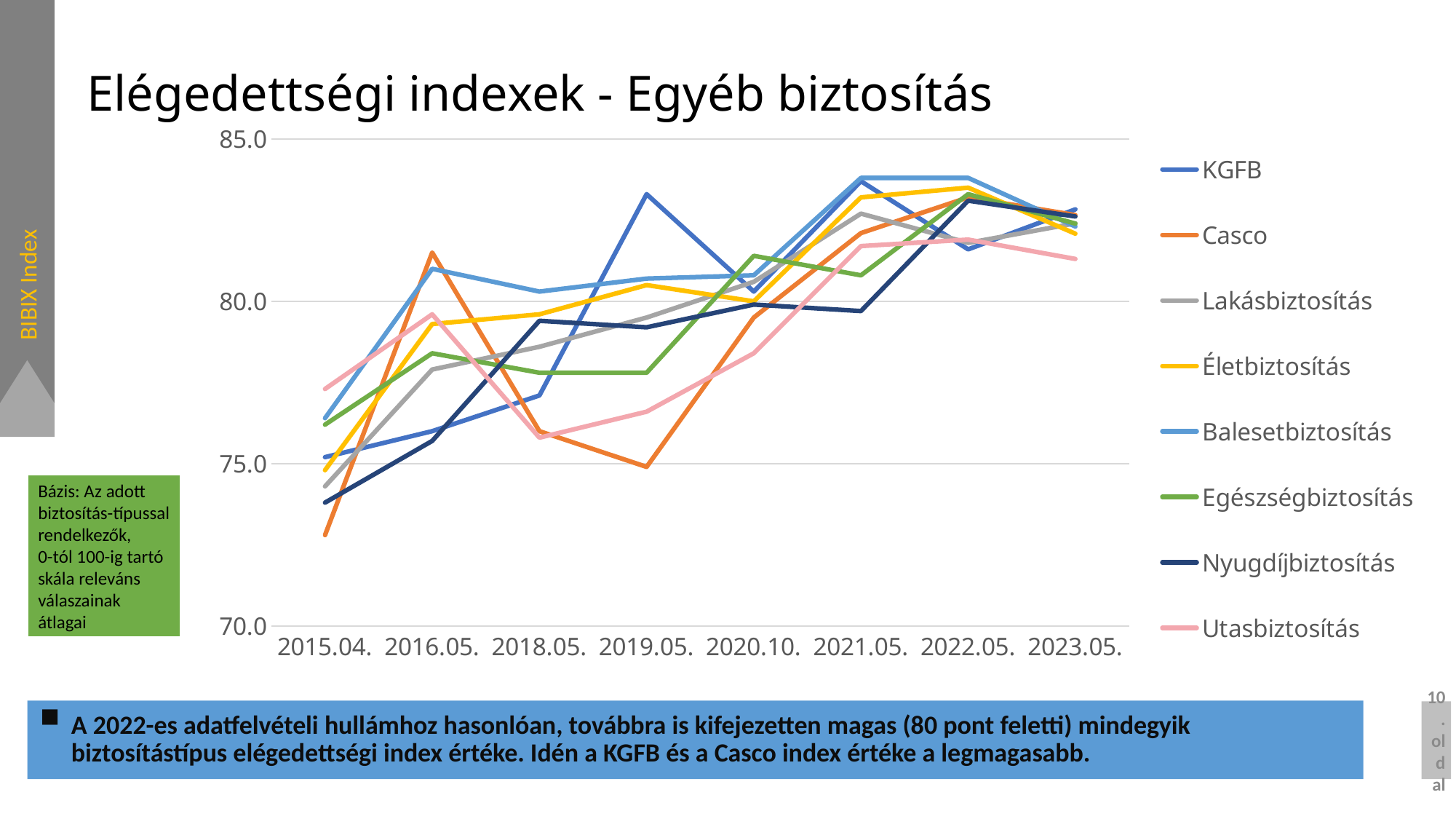
What kind of chart is shown on the slide? line chart What is the title of the chart? Elégedettségi indexek - Egyéb biztosítás Which series has the lowest value at 2015.04.? Casco Which series is listed first in the legend? KGFB Does the KGFB series overall rise or fall from 2015.04. to 2023.05.? rise Is the value for Nyugdíjbiztosítás at 2015.04. greater or less than 75? less How many series does the legend list? 8 Which series has the highest value at 2019.05.? KGFB Is the value for KGFB at 2019.05. greater or less than 80? greater How many time points are shown on the x axis? 8 Is the value for Casco at 2015.04. greater or less than 75? less Which series has the lowest value at 2023.05.? Utasbiztosítás